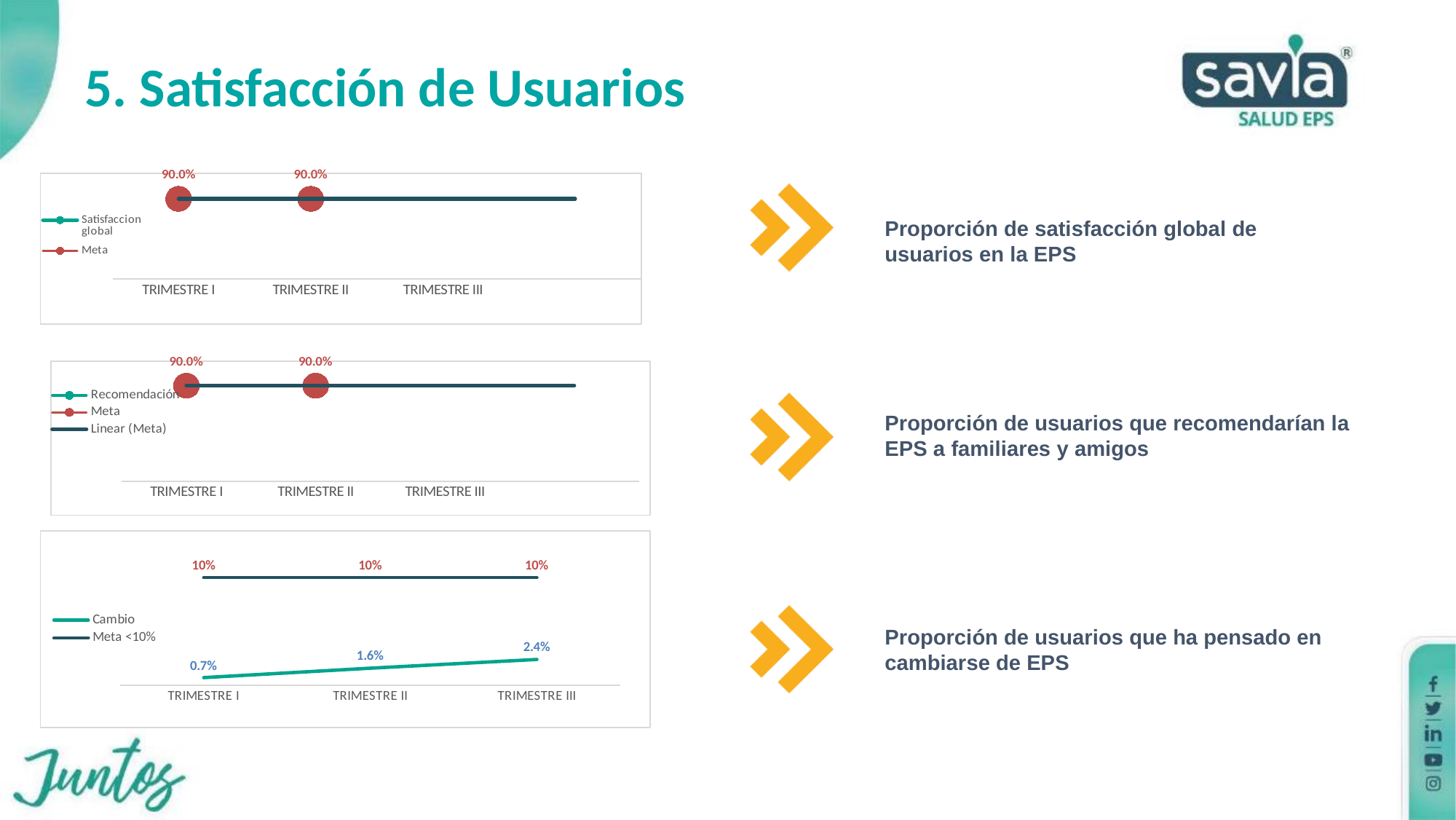
In the bottom chart, does the Cambio series rise or fall from TRIMESTRE I to TRIMESTRE III? rise How many series does the legend of the bottom chart list? 2 In the bottom chart, which trimester has the highest Cambio value? TRIMESTRE III In the bottom chart, which trimester has the lowest Cambio value? TRIMESTRE I In the bottom chart, what is the difference between the Cambio values for TRIMESTRE III and TRIMESTRE I? 1.7% In the top chart, what is the Meta value for TRIMESTRE I? 90.0% In the middle chart, what is the Meta value for TRIMESTRE II? 90.0% How many series does the legend of the middle chart list? 3 In the bottom chart, what is the value of the Meta <10% series for TRIMESTRE II? 10% In the bottom chart, what is the value of the Cambio series for TRIMESTRE II? 1.6% In the bottom chart, what is the value of the Cambio series for TRIMESTRE I? 0.7% In the bottom chart, what is the value of the Cambio series for TRIMESTRE III? 2.4%